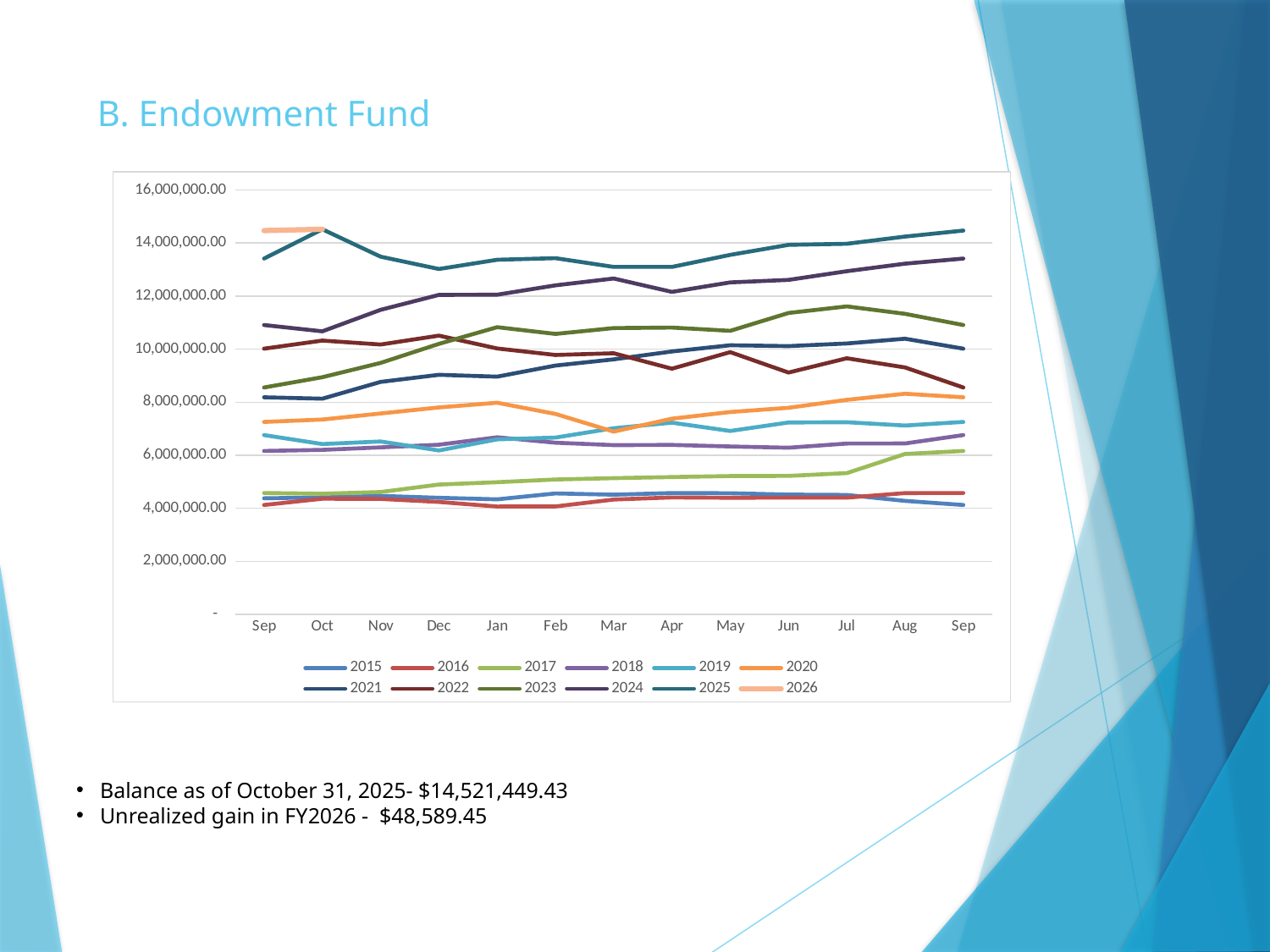
Which series has the lowest value at the final Sep point on the chart? 2015 In Aug, which series has the larger value, 2019 or 2018? 2019 Which series has the highest value at the final Sep point on the chart? 2025 Which series in the legend is plotted only for Sep and Oct? 2026 Does the 2024 series rise or fall overall from the first Sep to the final Sep? rise Is the value for the 2023 series in Jul greater or less than 12,000,000.00? less Is the value for the 2020 series in Mar greater or less than 8,000,000.00? less How many month labels are shown along the x axis of the chart? 13 How many series does the chart's legend list? 12 Which series has the highest value at the first Sep point on the chart? 2026 What kind of chart is shown on the slide? line chart Is the value for the 2025 series at the final Sep point greater or less than 14,000,000.00? greater